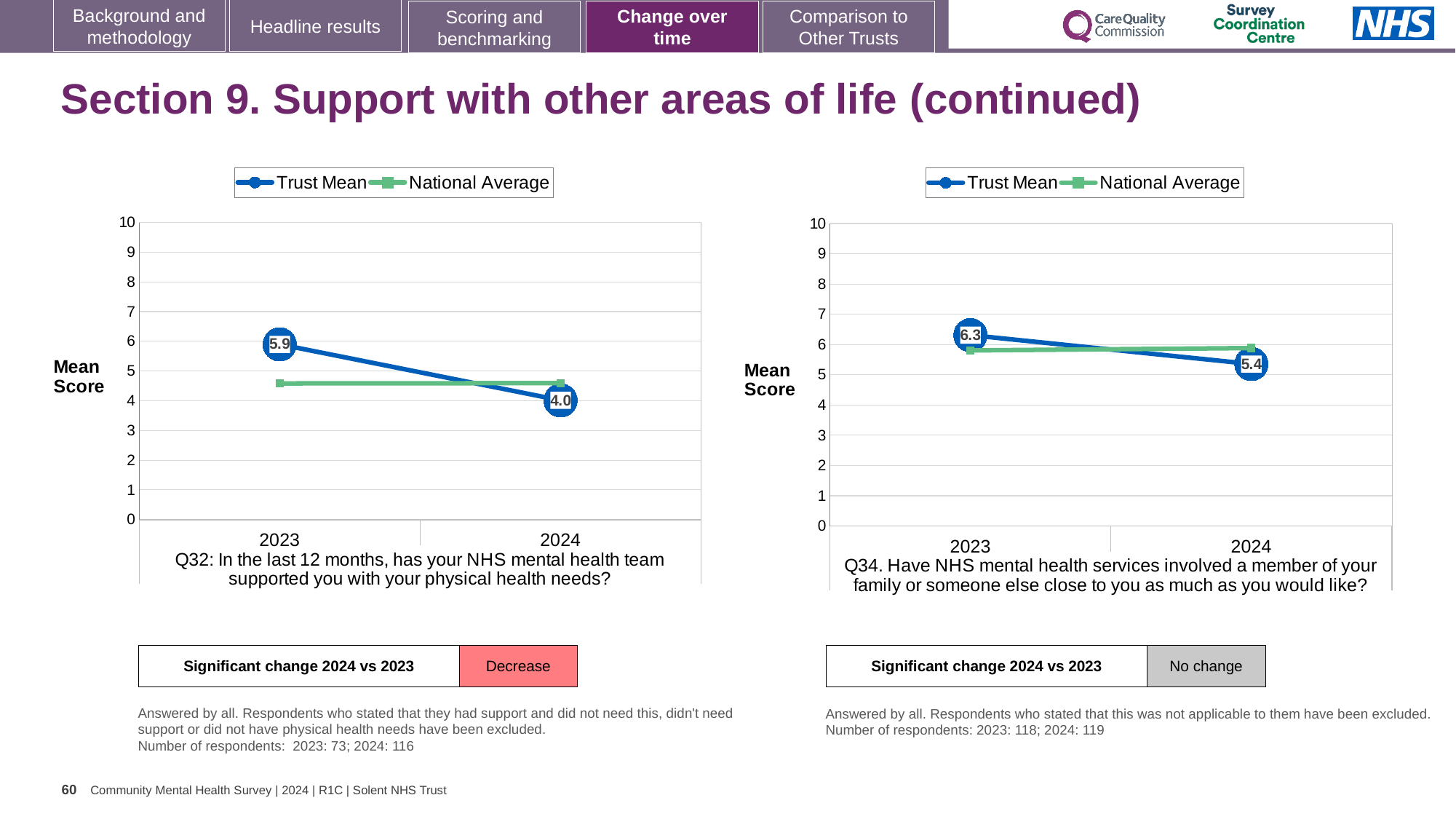
In the left chart (Q32), which is larger in 2023, the Trust Mean or the National Average? Trust Mean In the left chart (Q32), what is the Trust Mean for 2024? 4.0 In the left chart (Q32), does the Trust Mean rise or fall from 2023 to 2024? fall In the left chart (Q32), what is the Trust Mean for 2023? 5.9 What does the box below the right chart (Q34) say about significant change 2024 vs 2023? No change In the right chart (Q34), what is the Trust Mean for 2024? 5.4 What kind of chart is the right chart (Q34)? line chart In the right chart (Q34), what is the difference between the Trust Mean in 2023 and 2024? 0.9 In the left chart (Q32), by how much did the Trust Mean fall from 2023 to 2024? 1.9 How many series does the legend of the left chart (Q32) list? 2 In the left chart (Q32), is the National Average for 2023 greater or less than 5? less In the right chart (Q34), what is the Trust Mean for 2023? 6.3